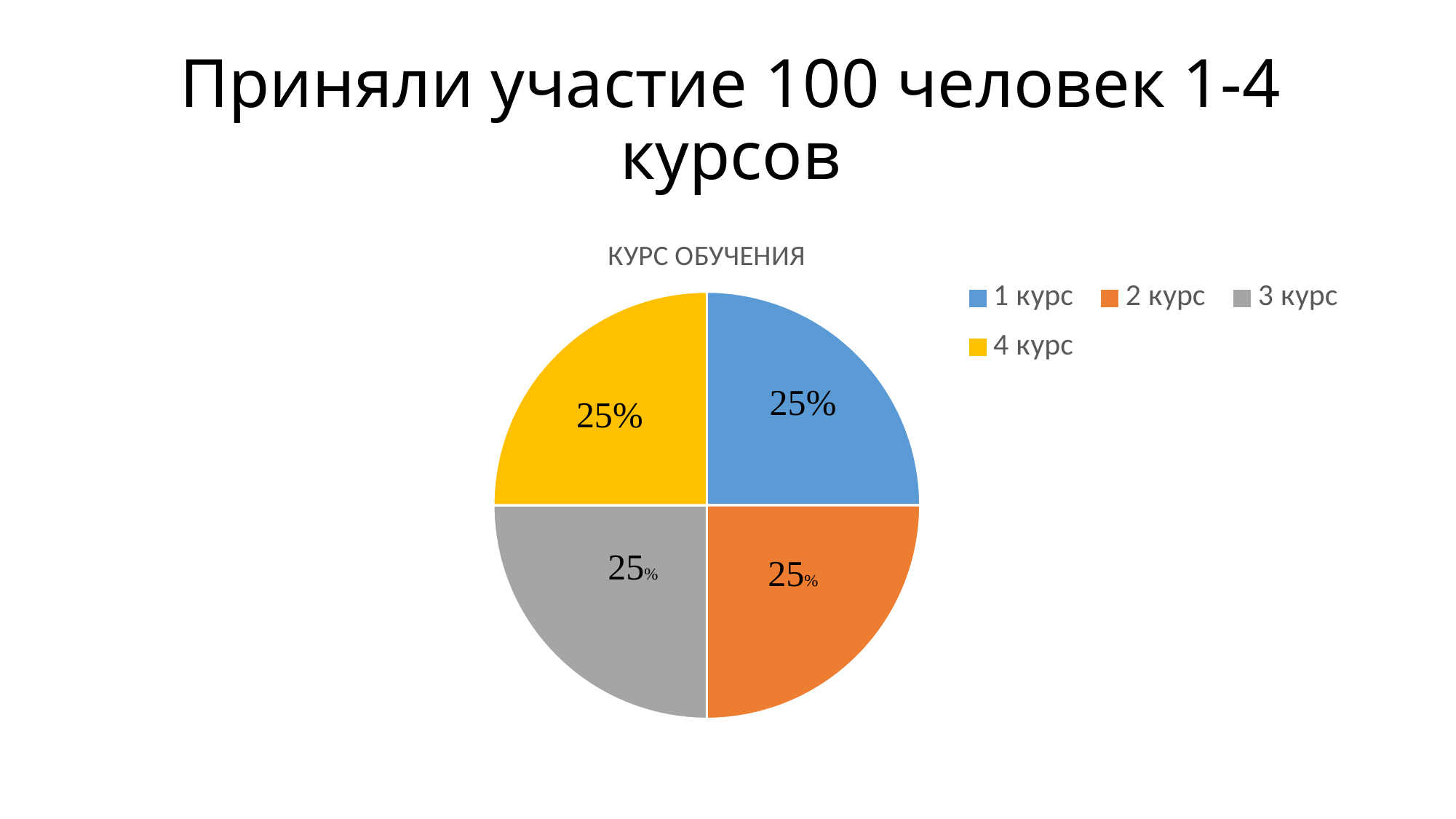
What kind of chart is shown on the slide? pie chart How many slices does the pie chart have? 4 What share of the pie does 3 курс have? 25% What share of the pie does 2 курс have? 25% What is the value labelled on the blue slice? 25% What share of the pie does 1 курс have? 25% What is the title of the chart? КУРС ОБУЧЕНИЯ How many entries does the legend list? 4 What is the value labelled on the orange slice? 25% Which colour represents 4 курс in the pie chart? yellow What is the difference between the shares of 1 курс and 3 курс? 0%